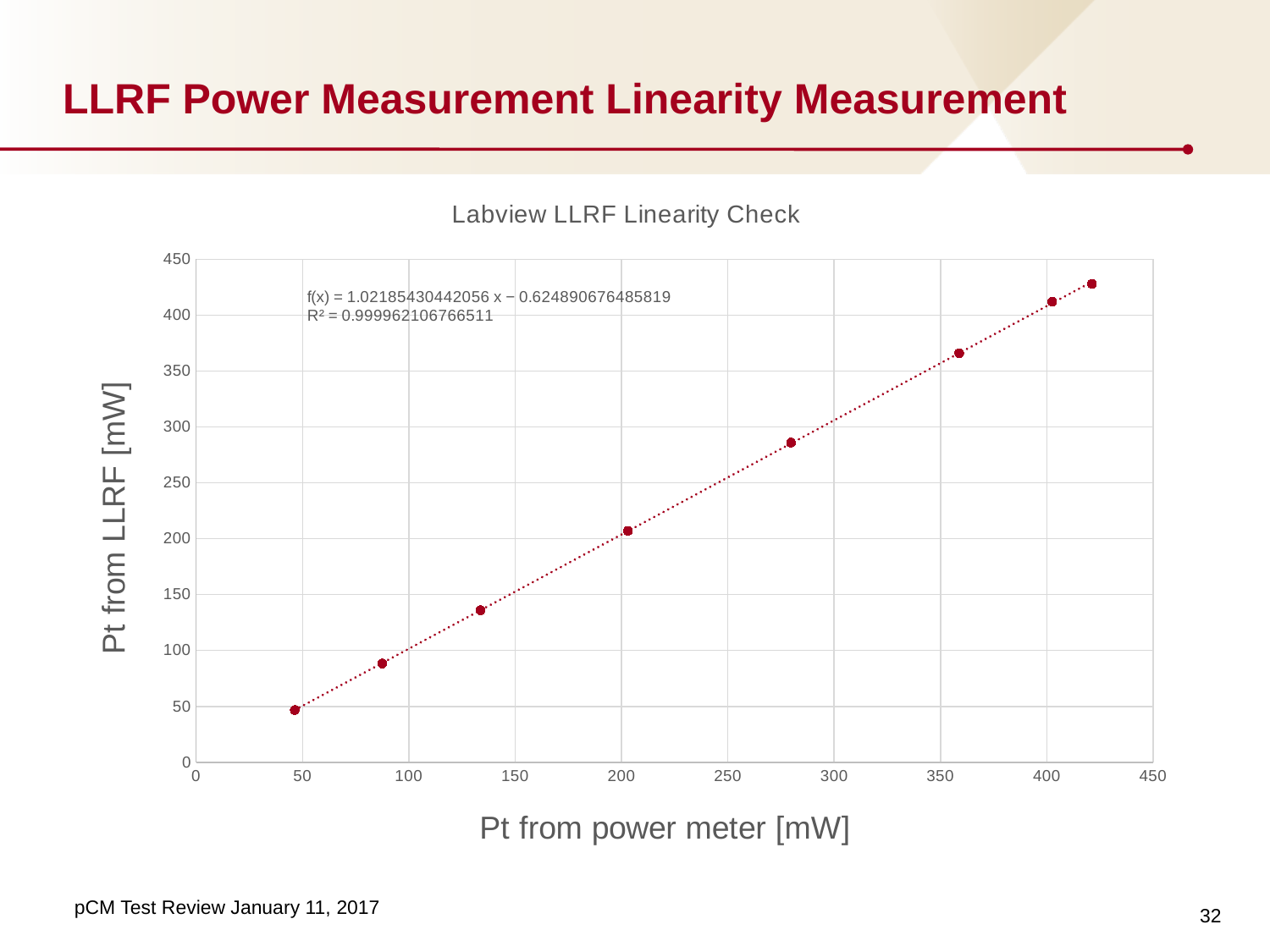
What is the title of the chart? Labview LLRF Linearity Check Which data point has the highest Pt from LLRF value, the leftmost or the rightmost? the rightmost How many data points are plotted on the chart? 8 What is the label of the y axis? Pt from LLRF [mW] Is the Pt from LLRF value for the rightmost data point greater or less than 400? greater Is the Pt from LLRF value for the data point near 280 mW on the power meter axis greater or less than 250? greater Do the values of Pt from LLRF rise or fall as Pt from power meter increases? rise Is the Pt from LLRF value for the data point near 358 mW on the power meter axis greater or less than 350? greater What kind of chart is shown on the slide? scatter chart